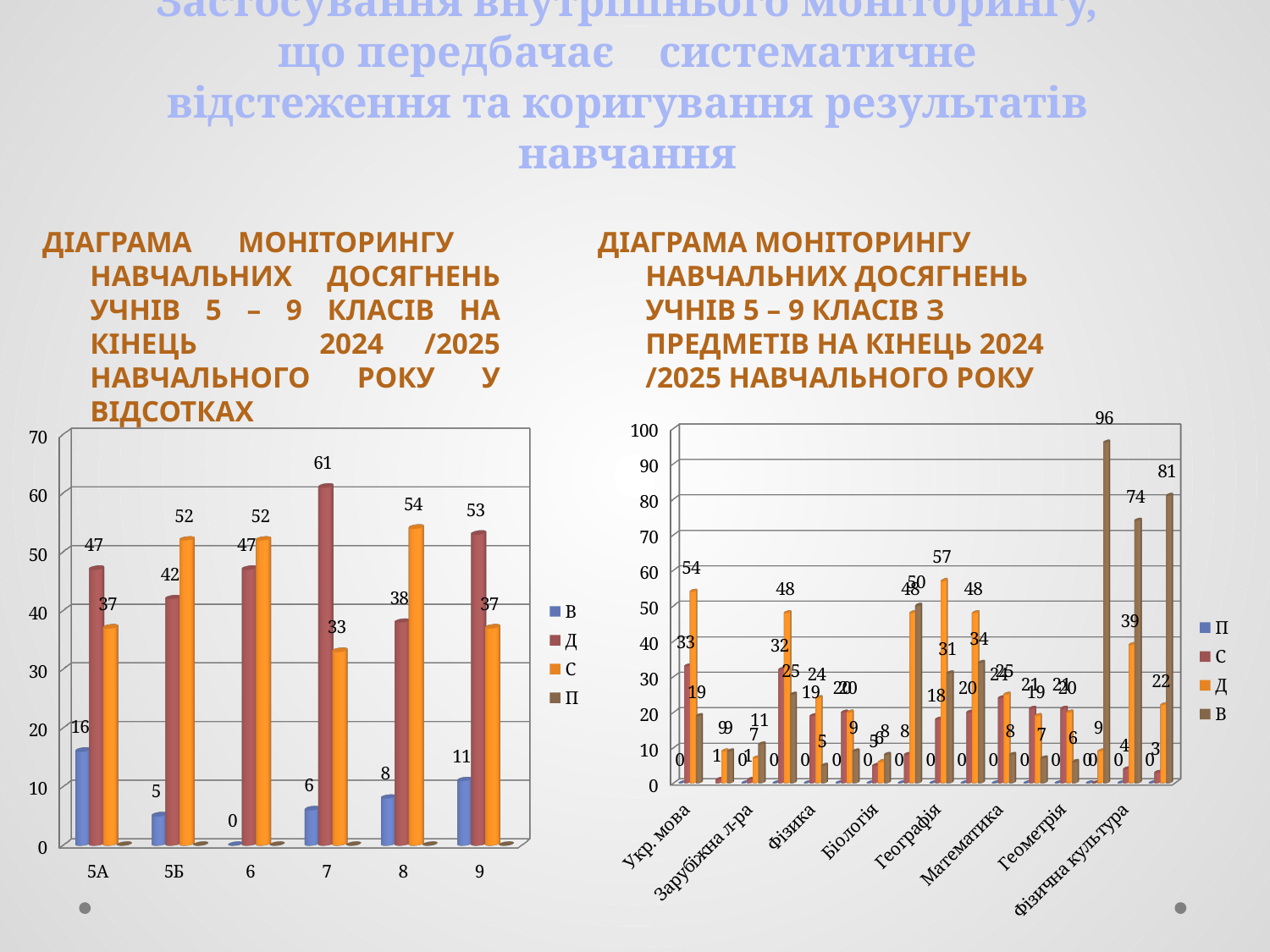
In the left chart, which class has the larger value for series В: 8 or 9? 9 How many class categories are shown on the x axis of the left chart? 6 How many series does the legend of the left chart list? 4 In the left chart, which class has the lowest value for series В? 6 In the left chart, what is the value of series С for class 5Б? 52 In the left chart, which class has the highest value for series Д? 7 What kind of chart is the left chart (monitoring of 5–9 classes in percent)? bar chart In the right chart, what is the value of series Д for Укр. мова? 54 In the left chart, what is the value of series Д for class 7? 61 In the left chart, what is the difference between series С and series Д for class 8? 16 In the left chart, what is the value of series В for class 5А? 16 In the right chart (monitoring by subjects), what is the highest data label shown? 96